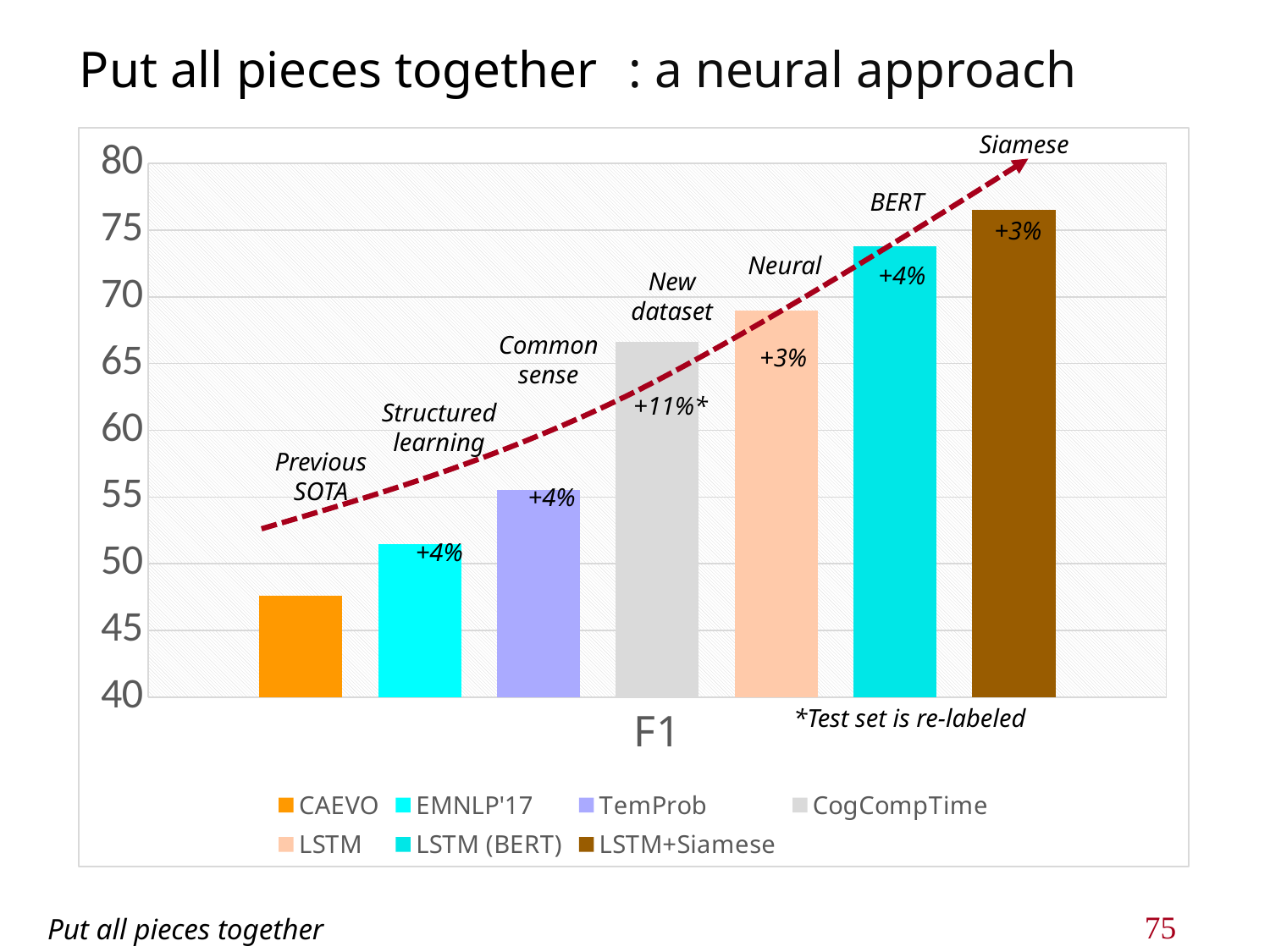
Which series has the highest F1 bar? LSTM+Siamese What improvement label is printed on the CogCompTime bar? +11%* How many series does the legend list? 7 Is the F1 value for CAEVO greater or less than 50? less Which has a higher F1 bar, LSTM (BERT) or LSTM? LSTM (BERT) What is the label on the x axis of the chart? F1 What kind of chart is shown on the slide? bar chart Is the F1 value for TemProb greater or less than 60? less Is the F1 value for LSTM (BERT) greater or less than 70? greater Which has a higher F1 bar, CogCompTime or TemProb? CogCompTime Do the F1 bars rise or fall from left to right across the series? rise Which series has the lowest F1 bar? CAEVO